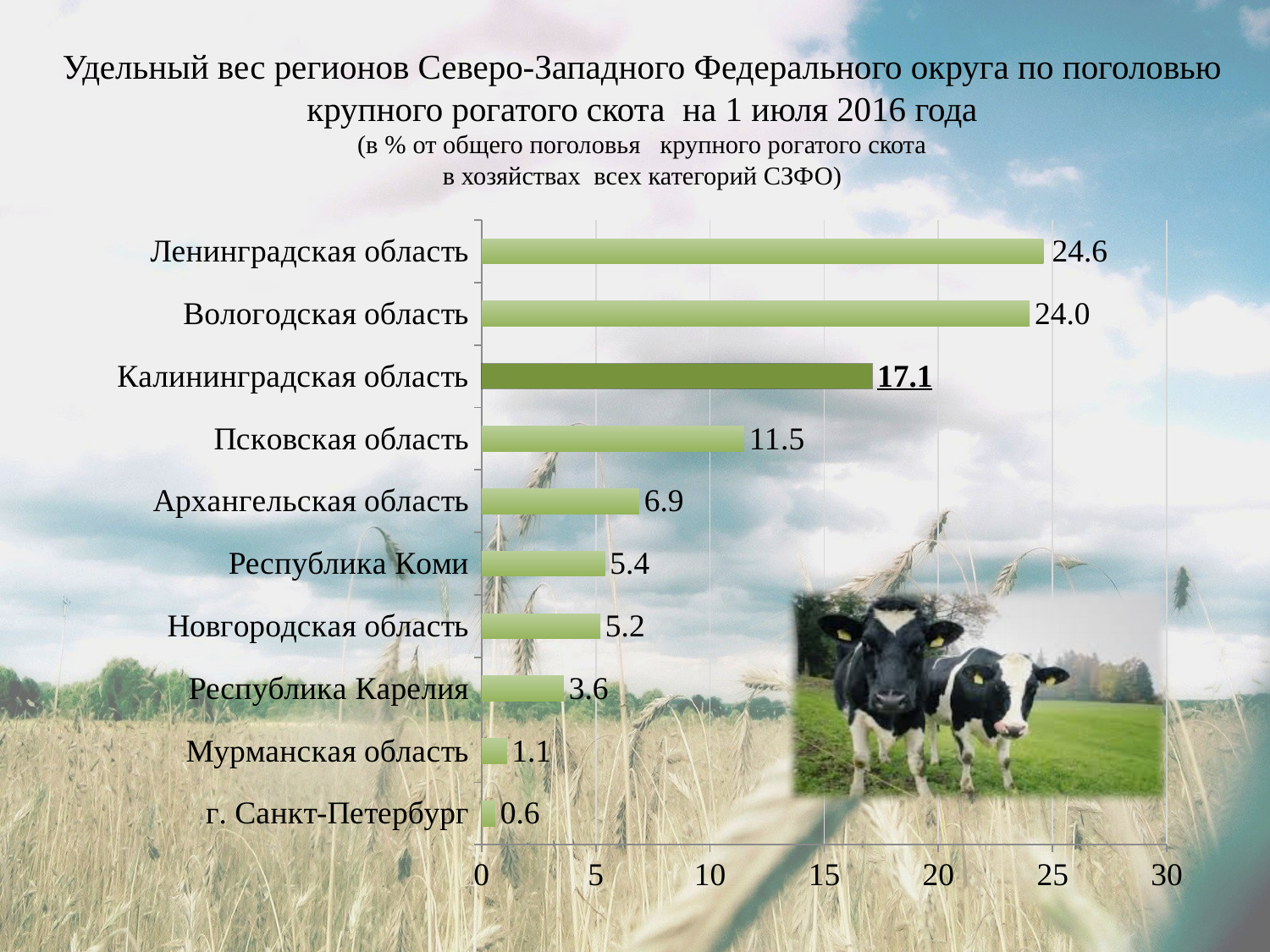
What kind of chart is shown on the slide? bar chart Is the value for Вологодская область greater or less than 20? greater Which region has the lowest value? г. Санкт-Петербург Which bar is drawn in a darker green than the others? Калининградская область What is the difference between the values for Ленинградская область and Вологодская область? 0.6 What is the value for Калининградская область? 17.1 Which region has the highest value? Ленинградская область How many regions are shown in the chart? 10 What is the value for Мурманская область? 1.1 What is the value for Псковская область? 11.5 What is the difference between the values for Калининградская область and Псковская область? 5.6 Which is larger, the value for Архангельская область or Республика Коми? Архангельская область